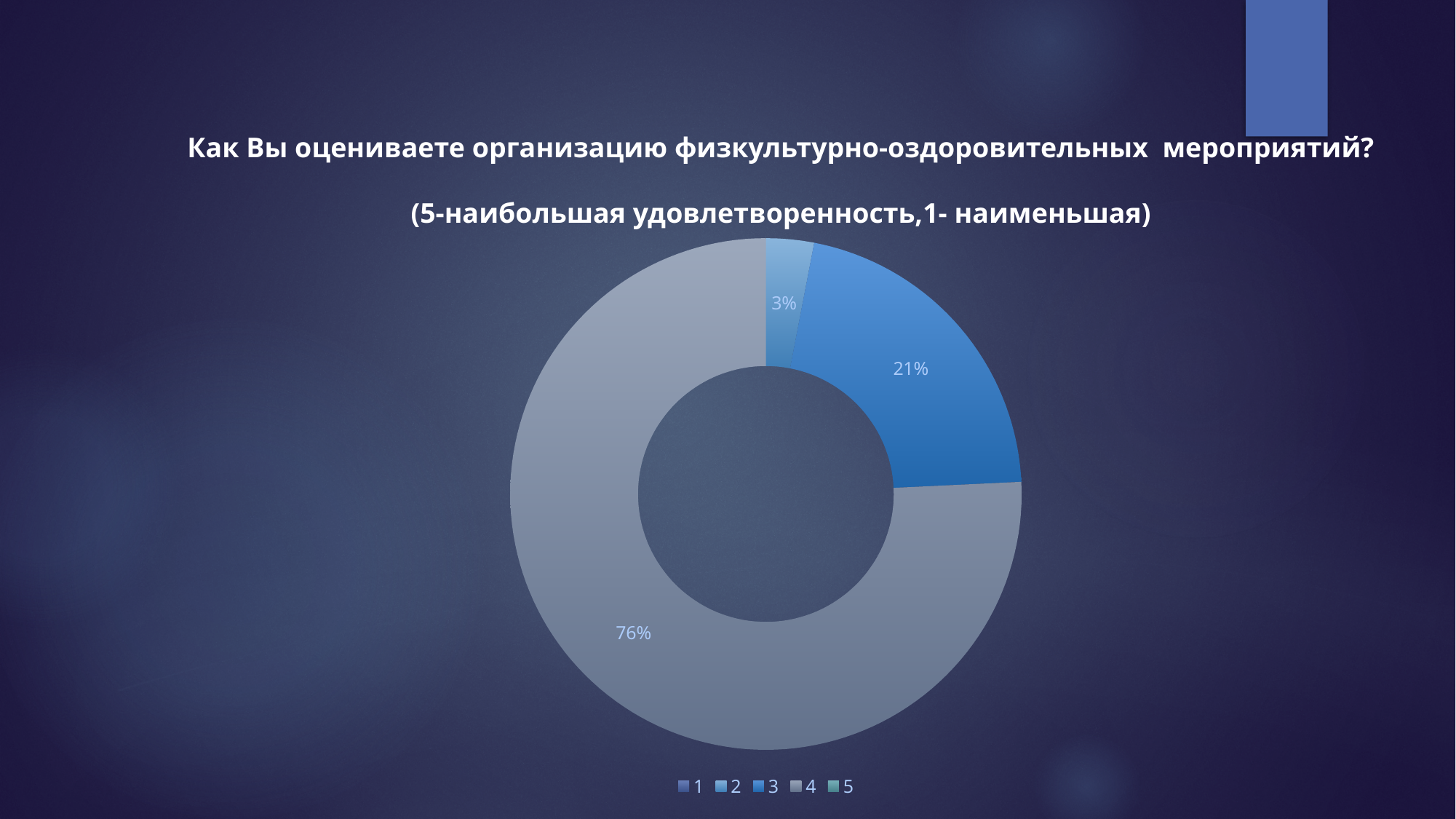
What is the smallest share labelled on the chart? 3% How many slices have a percentage label printed on the chart? 3 What share is shown for the blue slice (category 3)? 21% What kind of chart is shown on the slide? Doughnut (pie) chart What is the difference between the 76% slice and the 21% slice? 55% What question does the chart title ask? Как Вы оцениваете организацию физкультурно-оздоровительных мероприятий? What is the total of the three labelled slices (76%, 21% and 3%)? 100% Which slice is larger: the one labelled 21% or the one labelled 3%? 21% How many entries does the chart legend list? 5 What is the largest share shown on the chart? 76% What share is shown for the grey slice (category 4)? 76% What share is shown for the light blue slice (category 2)? 3%